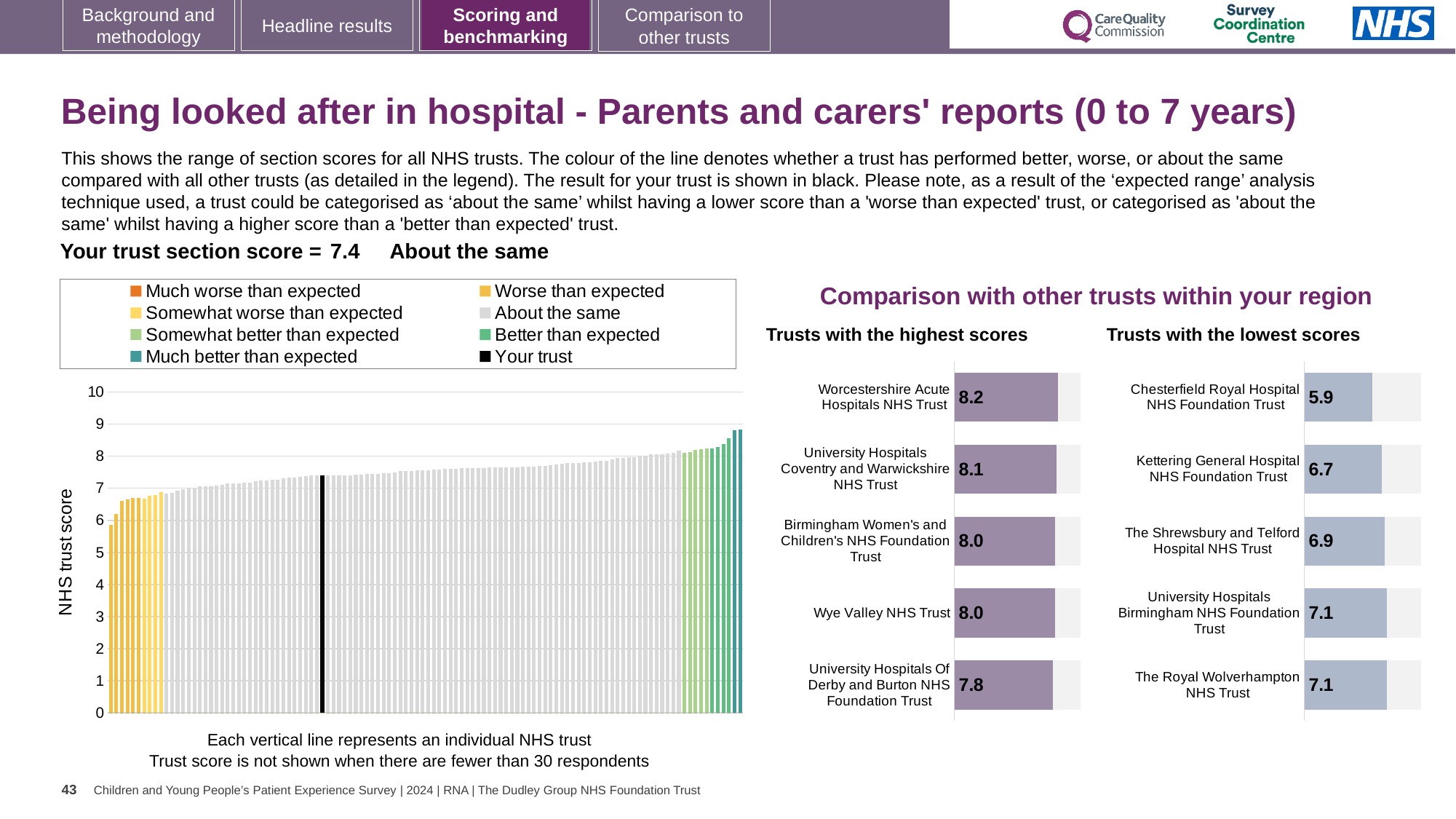
In the 'Trusts with the lowest scores' chart, what is the difference between the scores of The Royal Wolverhampton NHS Trust and Chesterfield Royal Hospital NHS Foundation Trust? 1.2 In the 'Trusts with the lowest scores' chart, what is the score for Chesterfield Royal Hospital NHS Foundation Trust? 5.9 In the 'Trusts with the lowest scores' chart, which has the higher score: Kettering General Hospital NHS Foundation Trust or The Shrewsbury and Telford Hospital NHS Trust? The Shrewsbury and Telford Hospital NHS Trust In the large chart on the left showing all NHS trusts, is the value of the highest bar greater or less than 8? greater How many trusts are listed in the 'Trusts with the highest scores' chart? 5 How many entries does the legend of the large chart on the left list? 8 In the large chart on the left showing all NHS trusts, do the bar values rise or fall from left to right? rise In the 'Trusts with the highest scores' chart, what is the difference between the scores of Worcestershire Acute Hospitals NHS Trust and University Hospitals Of Derby and Burton NHS Foundation Trust? 0.4 In the 'Trusts with the lowest scores' chart, which trust has the lowest score? Chesterfield Royal Hospital NHS Foundation Trust In the large chart on the left showing all NHS trusts, what is the section score for your trust (the black line)? 7.4 In the 'Trusts with the highest scores' chart, which trust has the lowest score shown? University Hospitals Of Derby and Burton NHS Foundation Trust In the 'Trusts with the highest scores' chart, what is the score for Worcestershire Acute Hospitals NHS Trust? 8.2